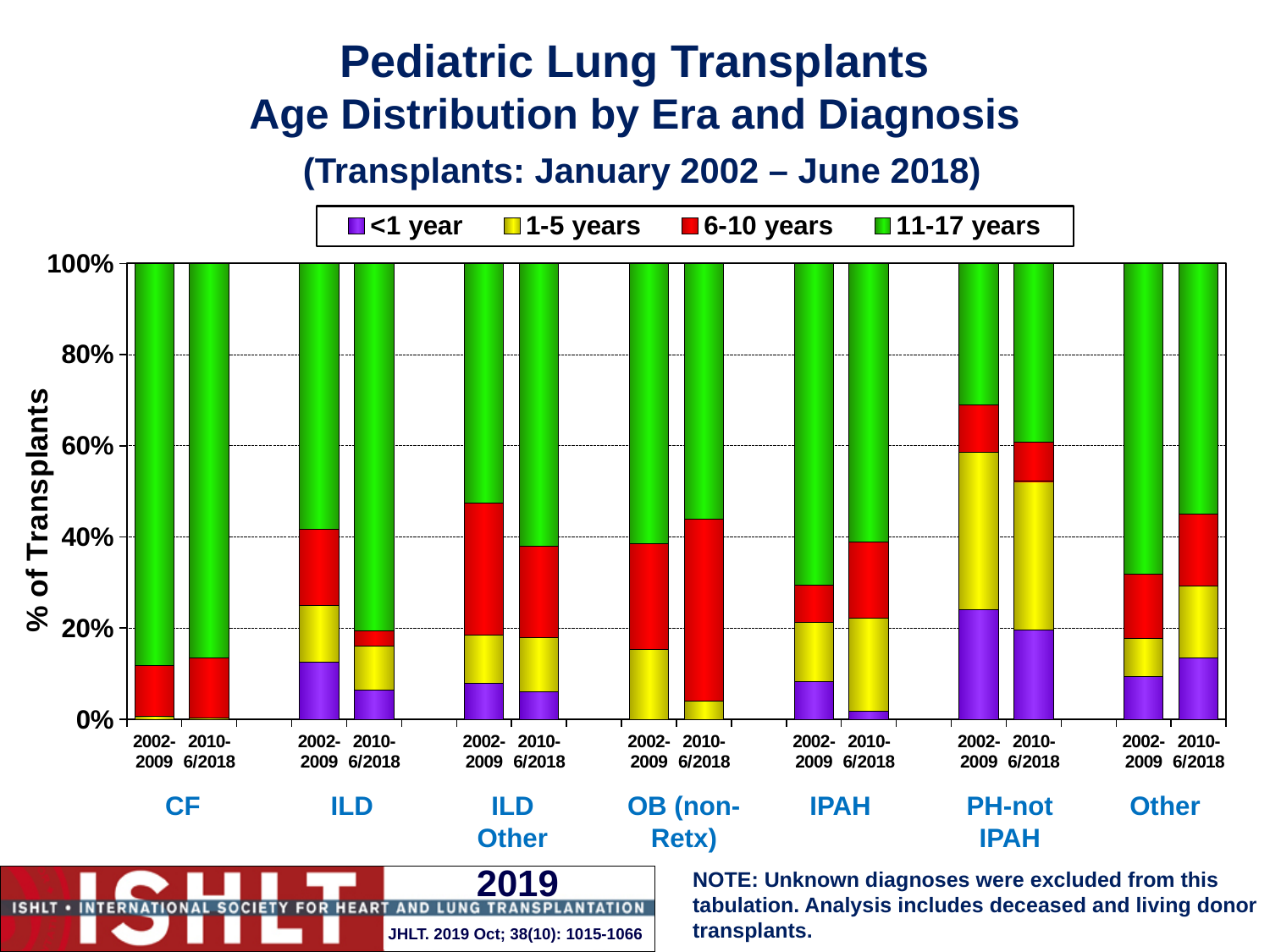
What kind of chart is shown on the slide? Stacked bar chart How many stacked bars are plotted in total? 14 In the IPAH 2010-6/2018 bar, is the share for <1 year greater or less than 20%? less How many series does the legend list? 4 In the CF 2002-2009 bar, is the share for 11-17 years greater or less than 80%? greater In the PH-not IPAH 2002-2009 bar, is the share for <1 year greater or less than 20%? greater How many diagnosis groups are shown along the x axis? 7 What does each stacked bar total? 100% What is the label on the y axis? % of Transplants Which diagnosis group has the largest <1 year share in the 2002-2009 era? PH-not IPAH For the Other diagnosis group, which era has the larger 11-17 years share, 2002-2009 or 2010-6/2018? 2002-2009 Which diagnosis group has the largest 11-17 years share in the 2010-6/2018 era? CF